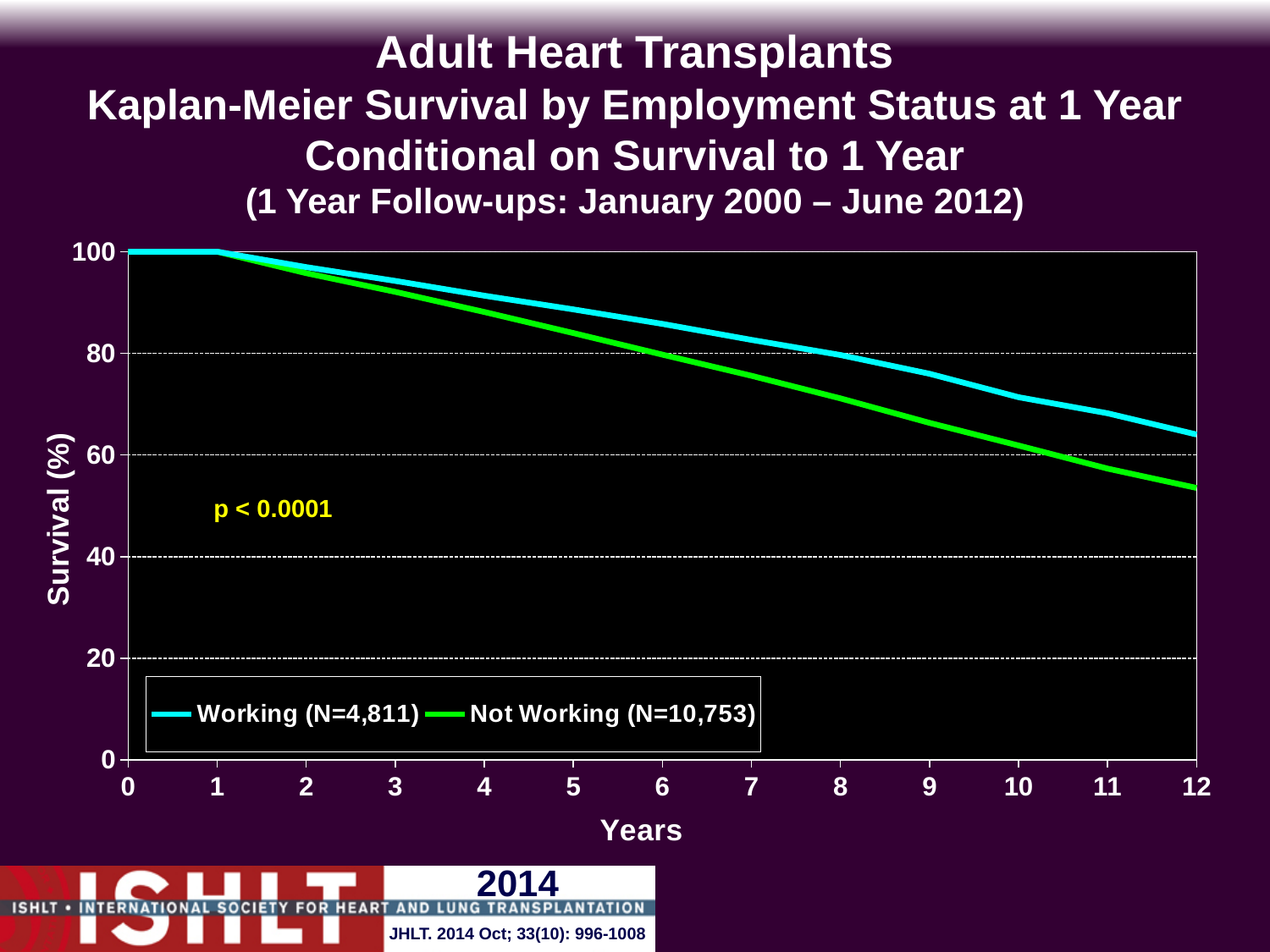
Is the survival for the Working group at 12 years greater or less than 60? greater What is the p-value shown on the chart? p < 0.0001 What kind of chart is shown on the slide? line chart How many series does the legend list? 2 Is the survival for the Not Working group at 8 years greater or less than 80? less Do the survival curves rise or fall as years increase? fall Is the survival for the Working group at 6 years greater or less than 80? greater What is the sample size (N) for the Not Working group shown in the legend? 10,753 Which series has the higher survival at 12 years, Working or Not Working? Working